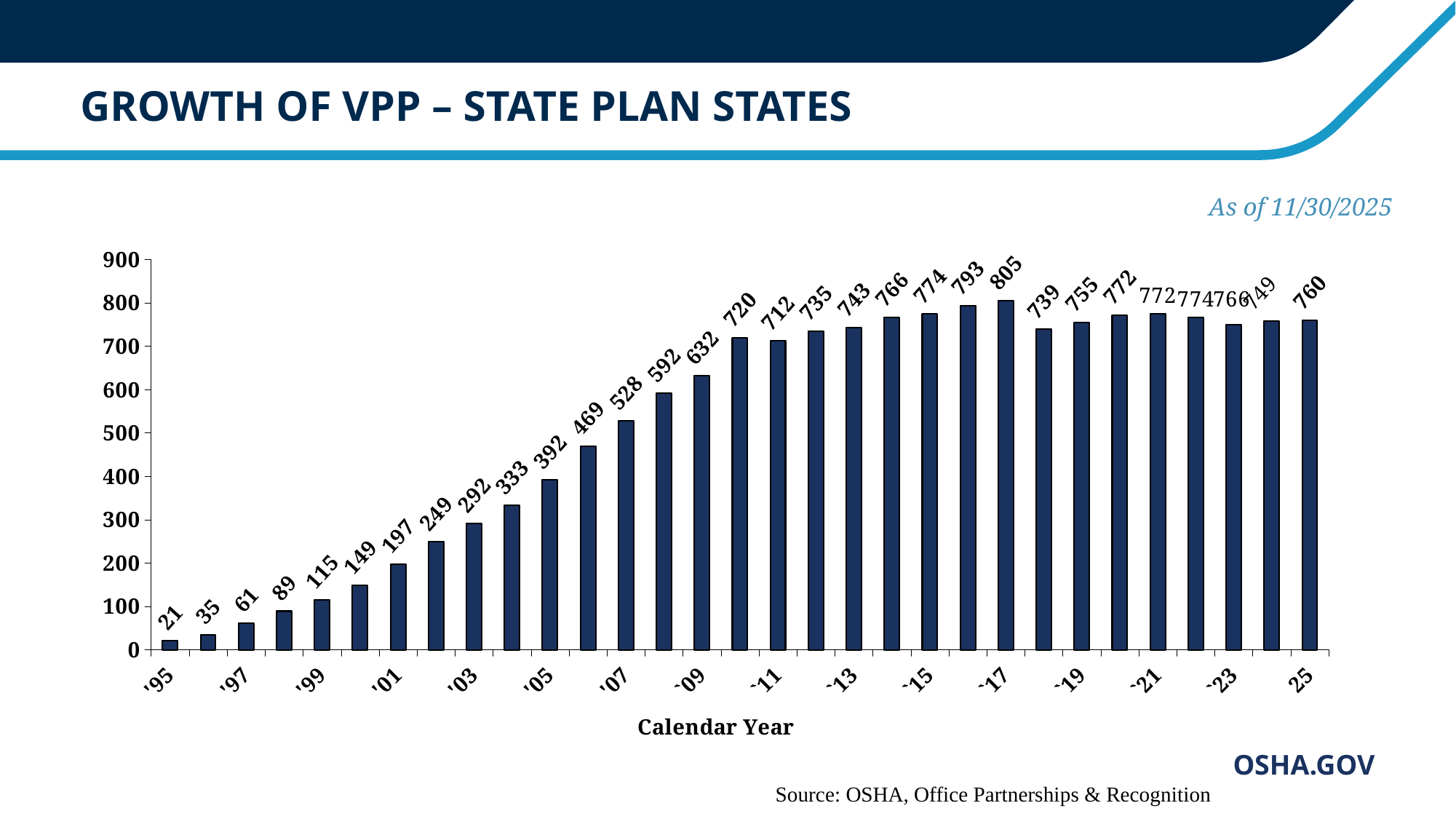
Which year has the lowest value? '95 What is the value for '09? 632 What is the x-axis title of the chart? Calendar Year What is the value for '25? 760 Do the values generally rise or fall from '95 to '17? rise What is the difference between the values for '17 and '19? 50 Which year has the highest value? '17 What is the value for '17? 805 What is the value for '95? 21 Which is larger, the value for '05 or the value for '07? '07 What type of chart is shown on the slide? bar chart Is the value for '13 greater or less than 700? greater